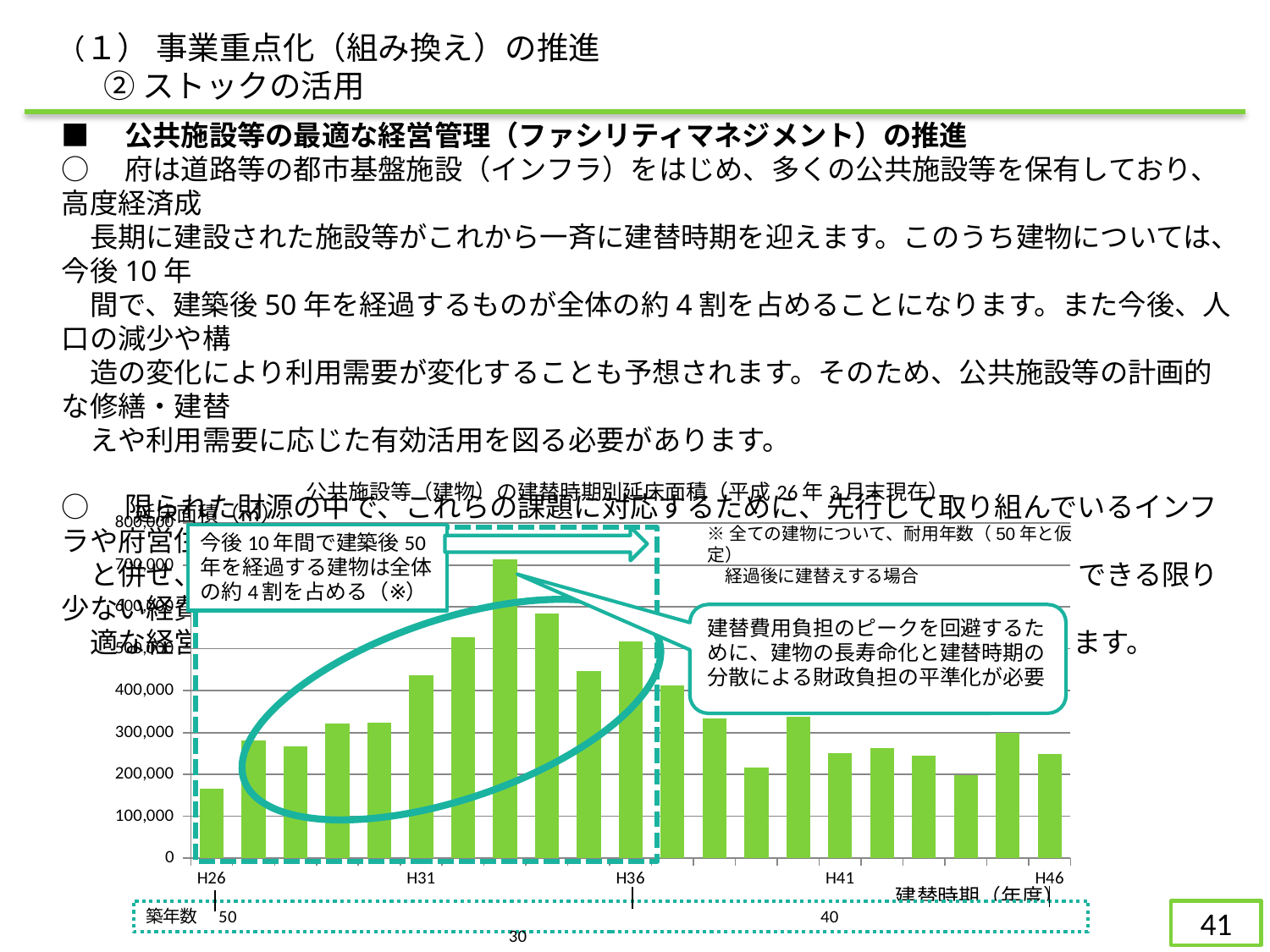
Which year has the lowest bar in the chart? H26 Is the value for H33 greater or less than 600,000? greater What is the title of the chart? 公共施設等（建物）の建替時期別延床面積（平成26年3月末現在） Which year has the highest bar in the chart? H33 How many bars are plotted in the chart? 21 Which is larger, the value for H31 or the value for H41? H31 Which is larger, the value for H33 or the value for H36? H33 What kind of chart is shown on the slide? bar chart Is the value for H41 greater or less than 200,000? greater Is the value for H26 greater or less than 200,000? less What is the label of the vertical axis of the chart? 延床面積（㎡）